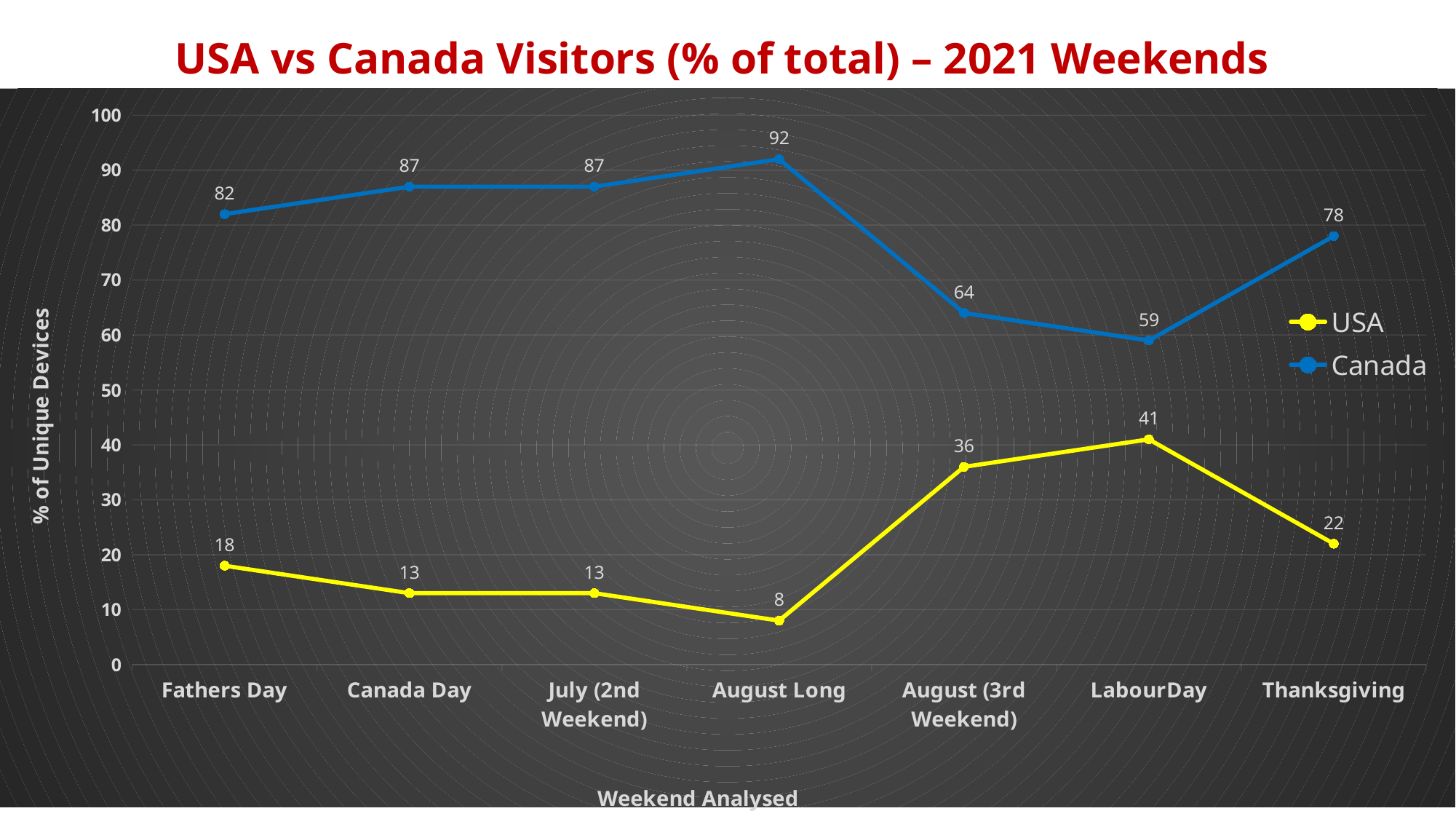
How many series does the legend list? 2 Which is larger: the USA value for August (3rd Weekend) or the USA value for Thanksgiving? August (3rd Weekend) How many weekends are shown on the x axis? 7 What kind of chart is shown? Line chart What is the title of the chart? USA vs Canada Visitors (% of total) – 2021 Weekends What is the USA value for Canada Day? 13 Which weekend has the highest Canada value? August Long Which weekend has the lowest USA value? August Long What is the USA value for LabourDay? 41 Does the Canada series rise or fall from August Long to LabourDay? Fall What is the difference between the Canada and USA values for Thanksgiving? 56 What is the Canada value for August Long? 92